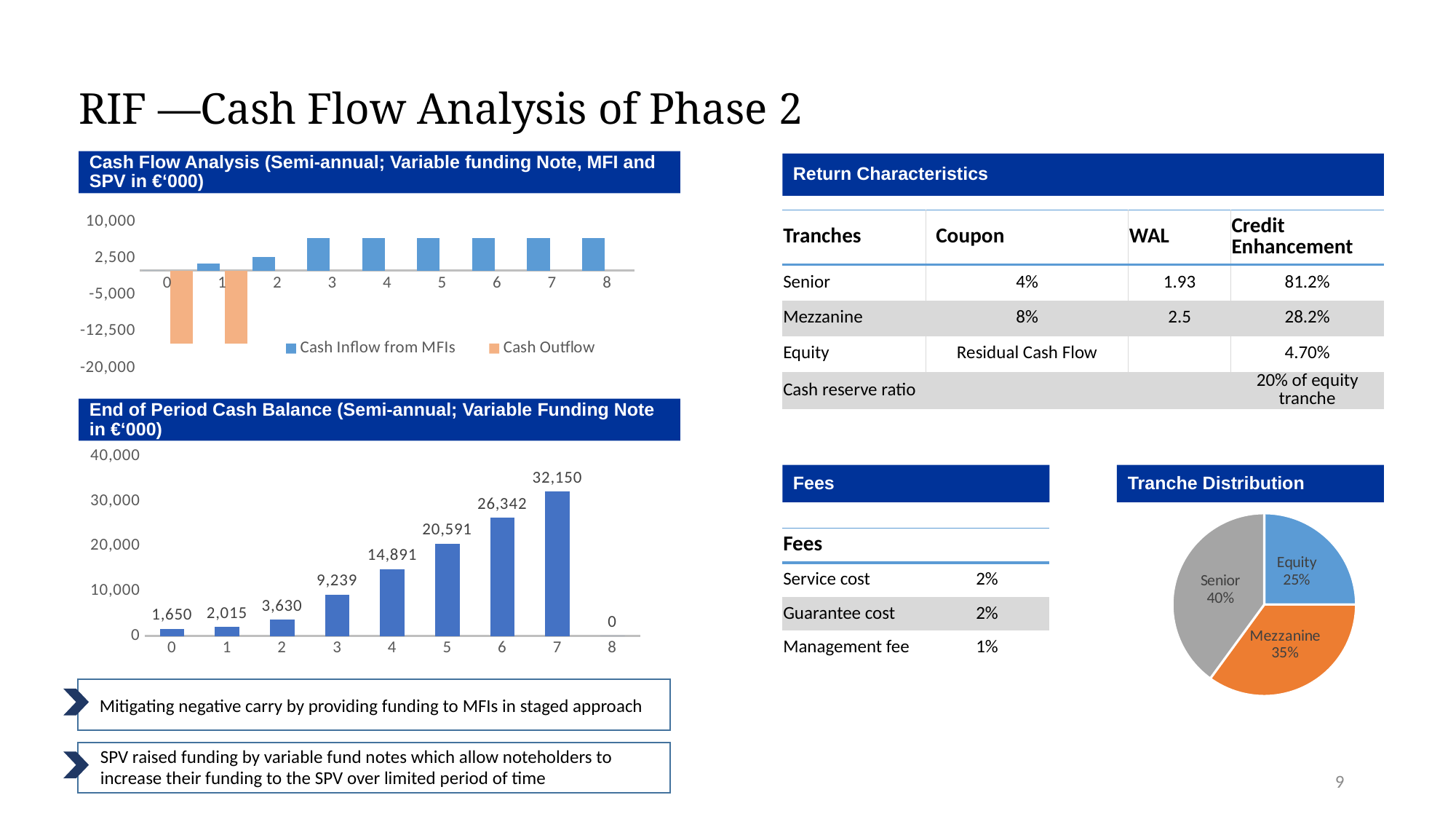
In the End of Period Cash Balance chart, what is the value for period 7? 32,150 In the End of Period Cash Balance chart, which period has the highest cash balance? 7 In the Cash Flow Analysis chart, is the Cash Outflow value for period 0 greater or less than -12,500? less In the Cash Flow Analysis chart, is the Cash Inflow from MFIs value for period 5 greater or less than 2,500? greater In the End of Period Cash Balance chart, what is the value for period 3? 9,239 In the Tranche Distribution pie chart, which tranche has the largest share? Senior In the End of Period Cash Balance chart, which period has the lowest cash balance? 8 In the End of Period Cash Balance chart, how many periods are plotted on the x axis? 9 In the End of Period Cash Balance chart, what is the difference between the values for period 7 and period 6? 5,808 In the Cash Flow Analysis chart, how many series does the legend list? 2 In the Tranche Distribution pie chart, what share does the Mezzanine tranche have? 35% In the End of Period Cash Balance chart, do the values rise or fall from period 0 to period 7? rise